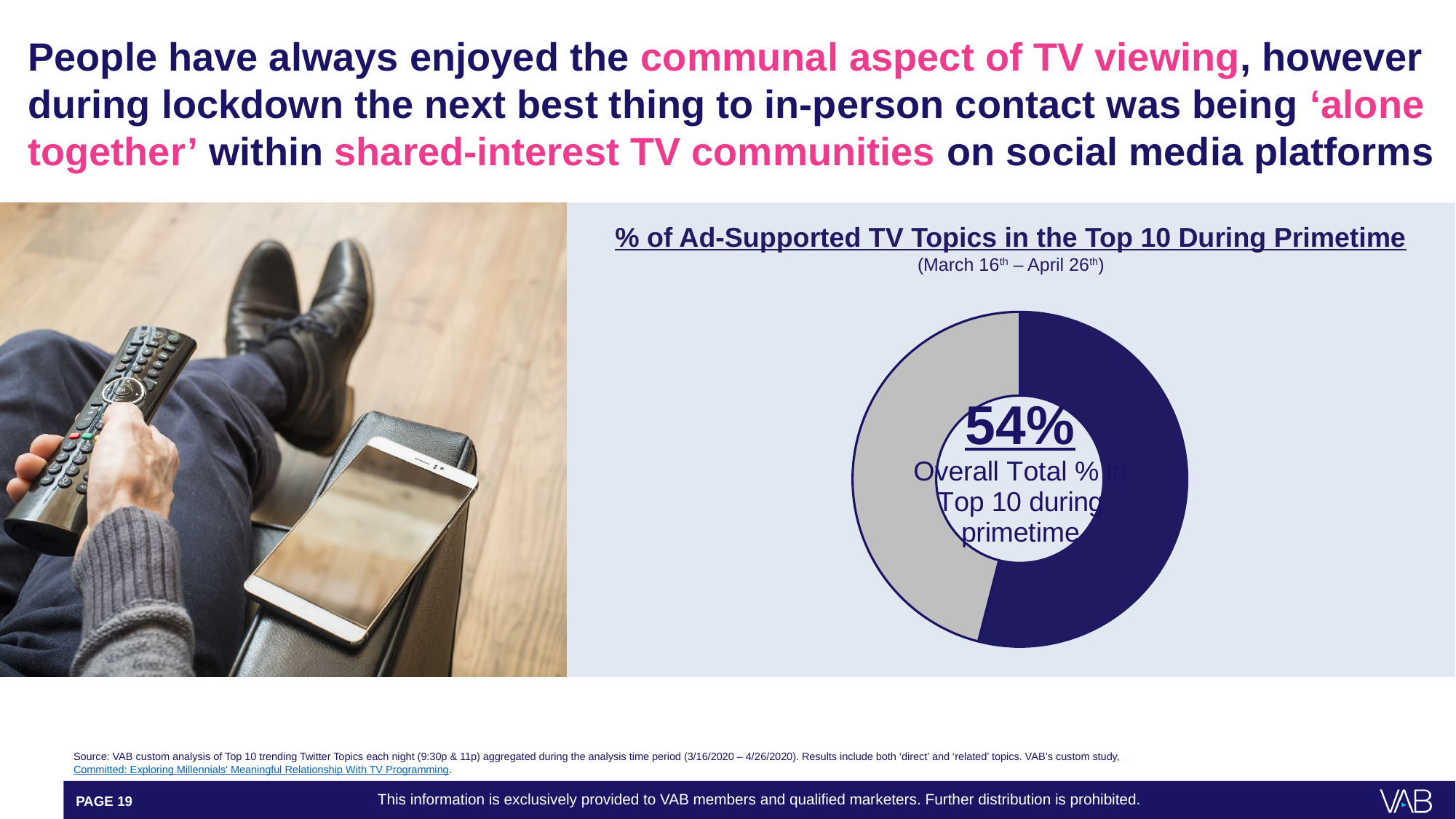
Is the value shown in the centre of the chart greater or less than 50%? greater What share of the pie does the dark blue slice represent? 54% What date range does the chart cover? March 16th – April 26th What is the title of the chart? % of Ad-Supported TV Topics in the Top 10 During Primetime What is the overall total % of ad-supported TV topics in the Top 10 during primetime shown in the chart? 54% Which slice of the pie chart is larger, the dark blue slice or the grey slice? the dark blue slice Which slice is the largest in the pie chart? the dark blue slice (54%) What share of the pie does the grey slice represent? 46% How many slices does the pie chart have? 2 What type of chart is shown on the slide? pie chart (donut)